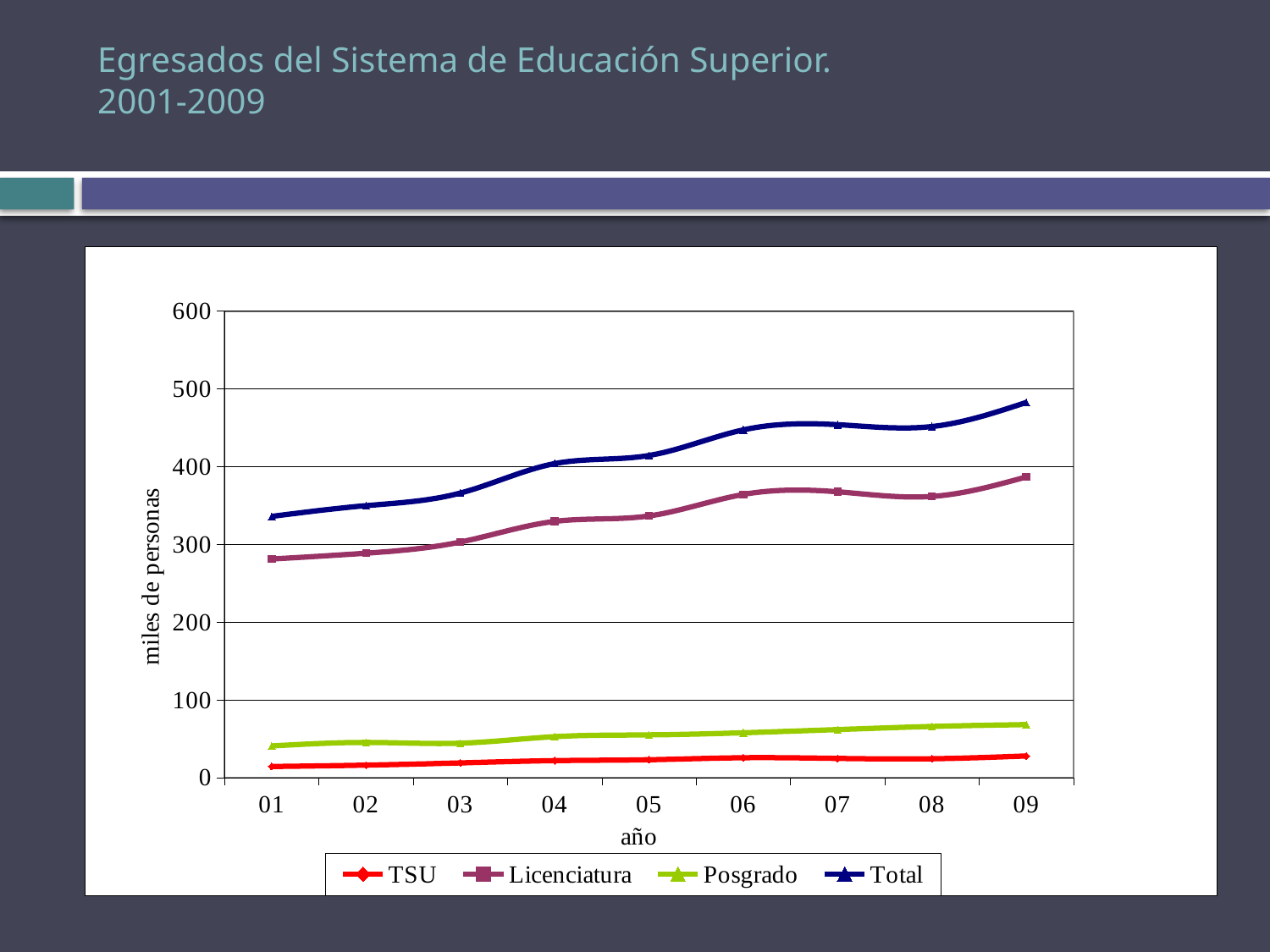
In which year is the Total series highest? 09 Is the value for Licenciatura in 01 greater or less than 300? less How many series does the legend list? 4 How many years are plotted along the x axis? 9 What kind of chart is shown on the slide? line chart Is the value for Total in 01 greater or less than 300? greater Does the Total series rise or fall from 01 to 09? rise In 05, which is larger: Licenciatura or Posgrado? Licenciatura Is the value for Posgrado in 09 greater or less than 100? less In which year is the Total series lowest? 01 What is the label on the vertical axis? miles de personas